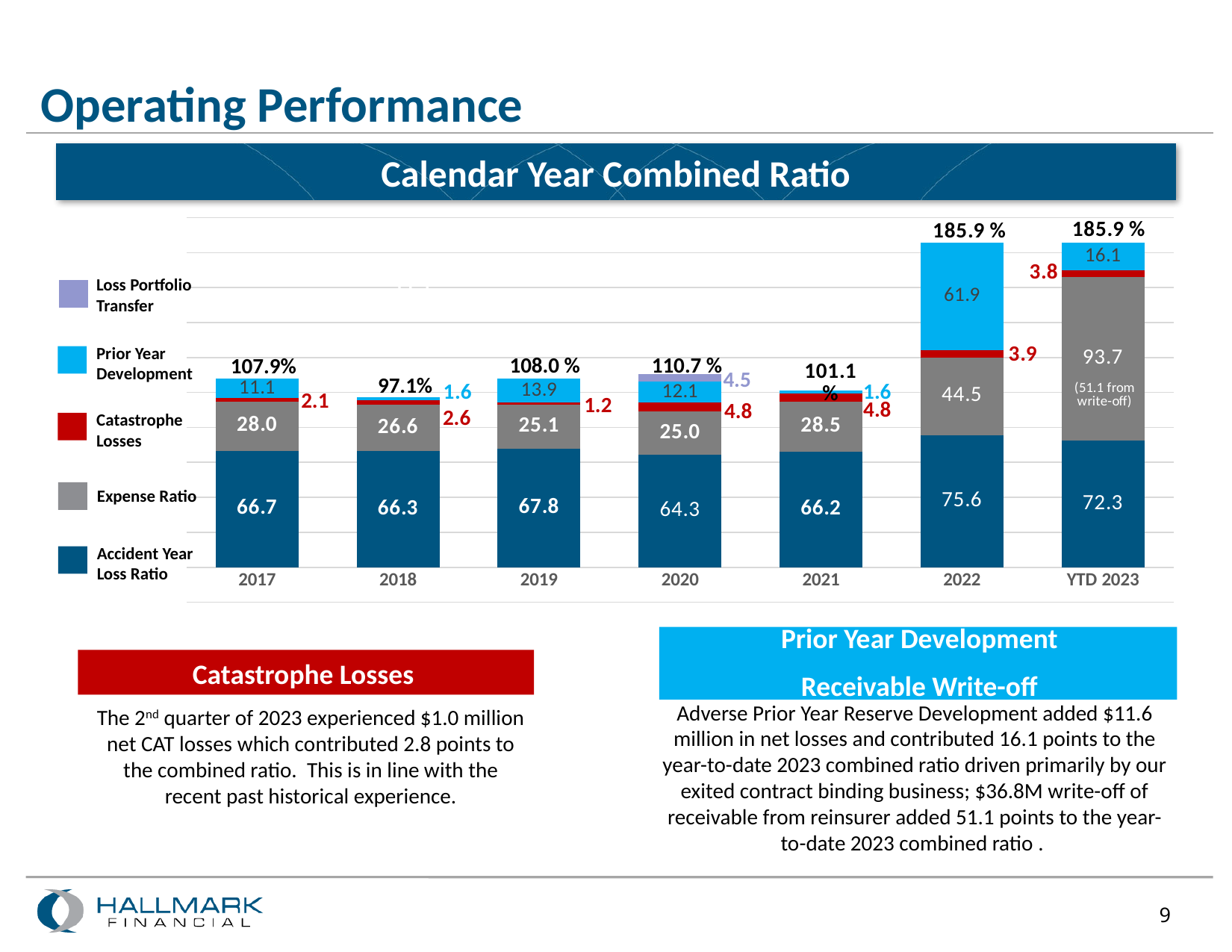
Which year has the highest Accident Year Loss Ratio? 2022 What is the combined ratio shown above the 2018 bar? 97.1% Which year has the lowest combined ratio? 2018 What kind of chart is shown? Stacked bar chart Which is larger, the Prior Year Development for 2019 or for 2017? 2019 How many series does the legend list? 5 What is the difference between the Expense Ratio for YTD 2023 and for 2022? 49.2 What is the Prior Year Development value for 2022? 61.9 What is the Accident Year Loss Ratio for 2019? 67.8 How many years (categories) are shown on the x axis? 7 What is the Expense Ratio for YTD 2023? 93.7 What is the Catastrophe Losses value for 2020? 4.8